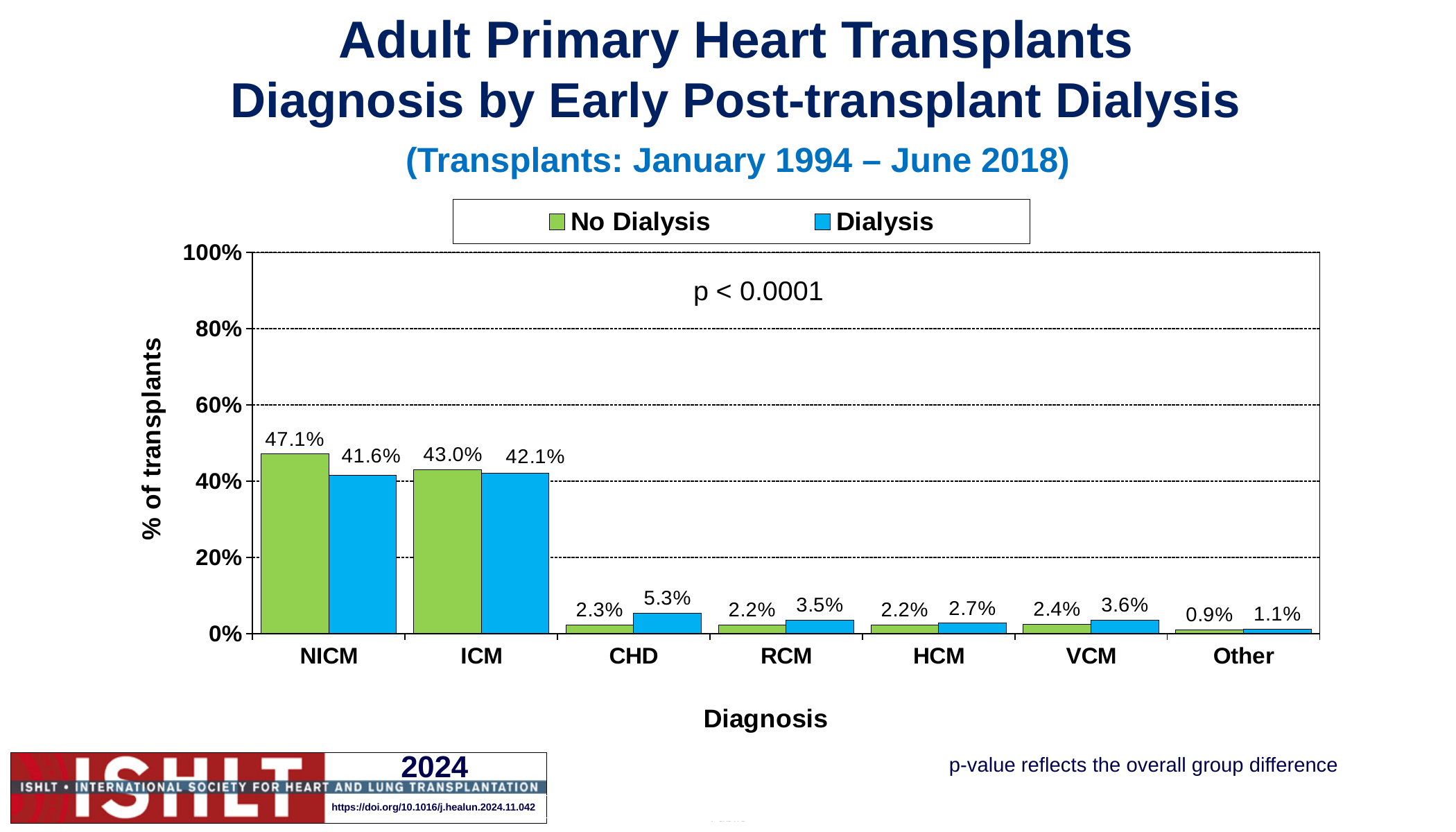
What is the difference between the No Dialysis and Dialysis values for NICM? 5.5% What percentage of transplants in the Dialysis group had a diagnosis of CHD? 5.3% What is the value for ICM in the Dialysis series? 42.1% What kind of chart is shown on the slide? Bar chart How many diagnosis categories are shown on the x axis? 7 What is the difference between the Dialysis and No Dialysis values for CHD? 3.0% What p-value is printed on the chart? p < 0.0001 How many series does the legend list? 2 For RCM, which series has the larger value, No Dialysis or Dialysis? Dialysis Which diagnosis has the highest percentage in the No Dialysis series? NICM Which diagnosis has the lowest percentage in the Dialysis series? Other What percentage of transplants in the No Dialysis group had a diagnosis of NICM? 47.1%